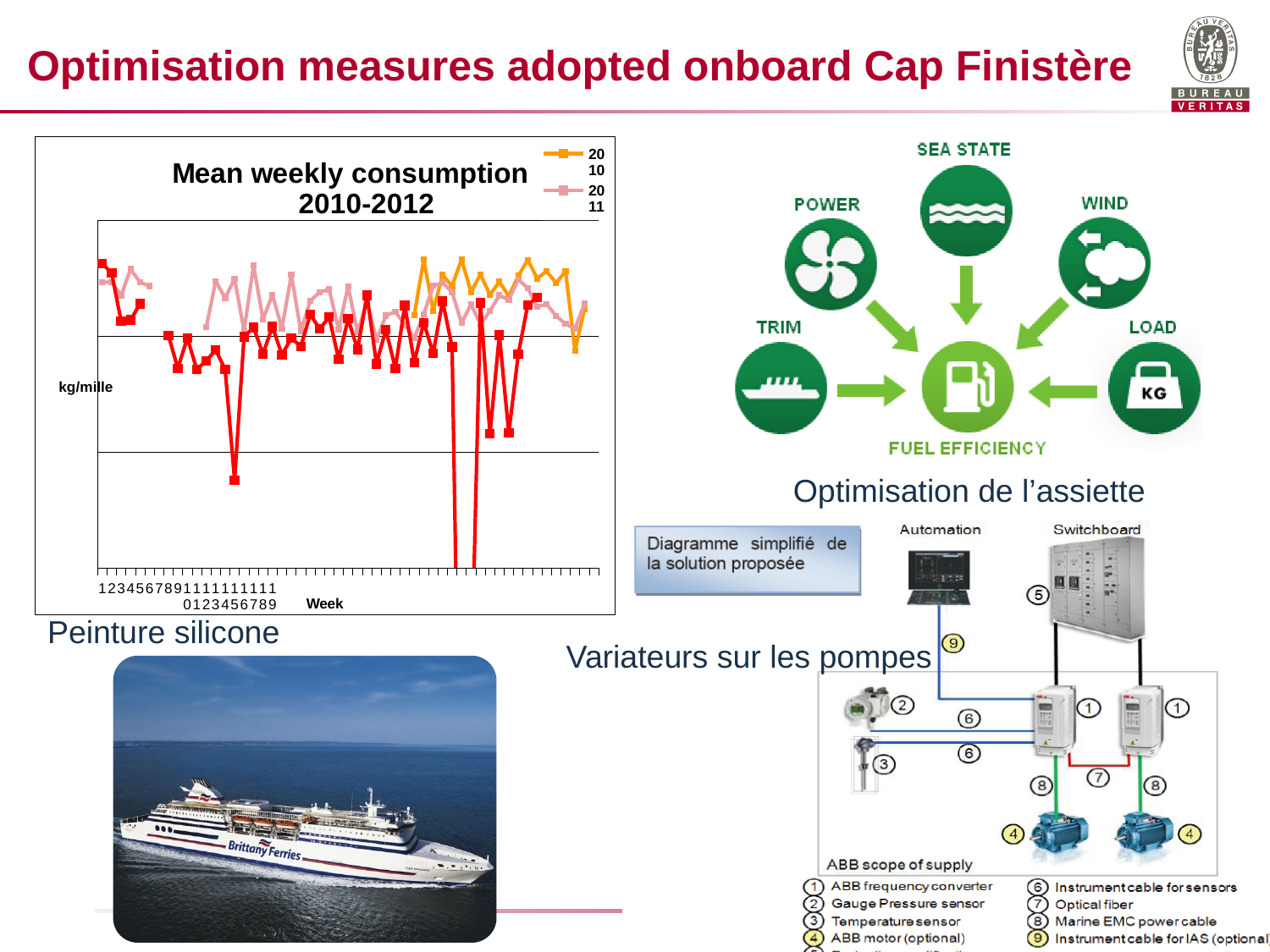
Which years are listed in the legend of the 'Mean weekly consumption 2010-2012' chart? 2010 and 2011 What kind of chart is the 'Mean weekly consumption 2010-2012' chart? line chart What is the title of the chart on the slide? Mean weekly consumption 2010-2012 What is the label of the horizontal axis of the 'Mean weekly consumption 2010-2012' chart? Week What unit is shown on the vertical axis of the 'Mean weekly consumption 2010-2012' chart? kg/mille How many series does the legend of the 'Mean weekly consumption 2010-2012' chart list? 2